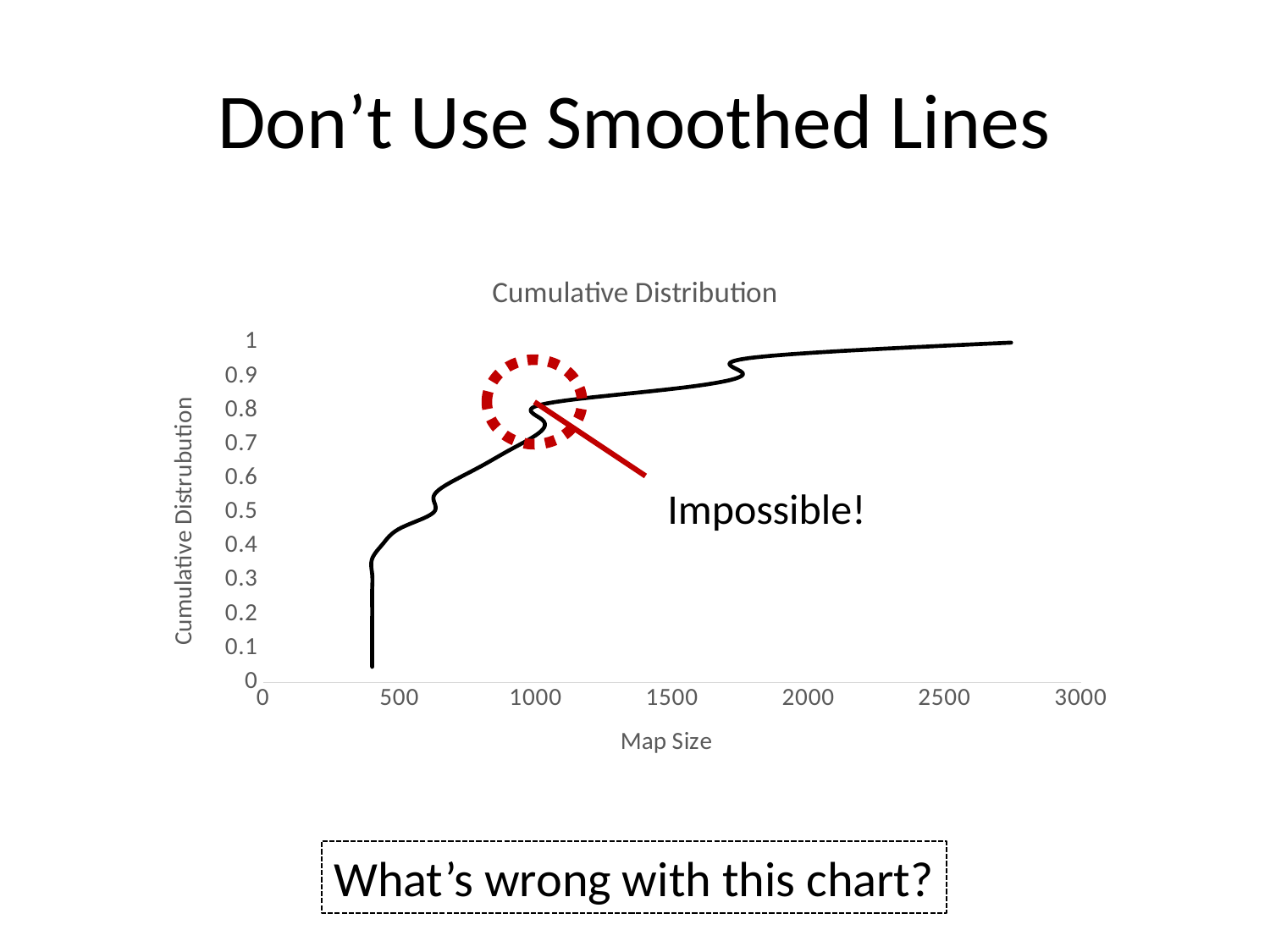
Is the value of the line at a Map Size of 2000 greater or less than 0.9? greater Is the value of the line at a Map Size of 2500 greater or less than 0.9? greater Is the value of the line at a Map Size of 1500 greater or less than 0.8? greater Do the values on the chart generally rise or fall as Map Size increases? rise What is the title of the chart? Cumulative Distribution What is the label of the x axis of the chart? Map Size What kind of chart is shown on the slide? line chart